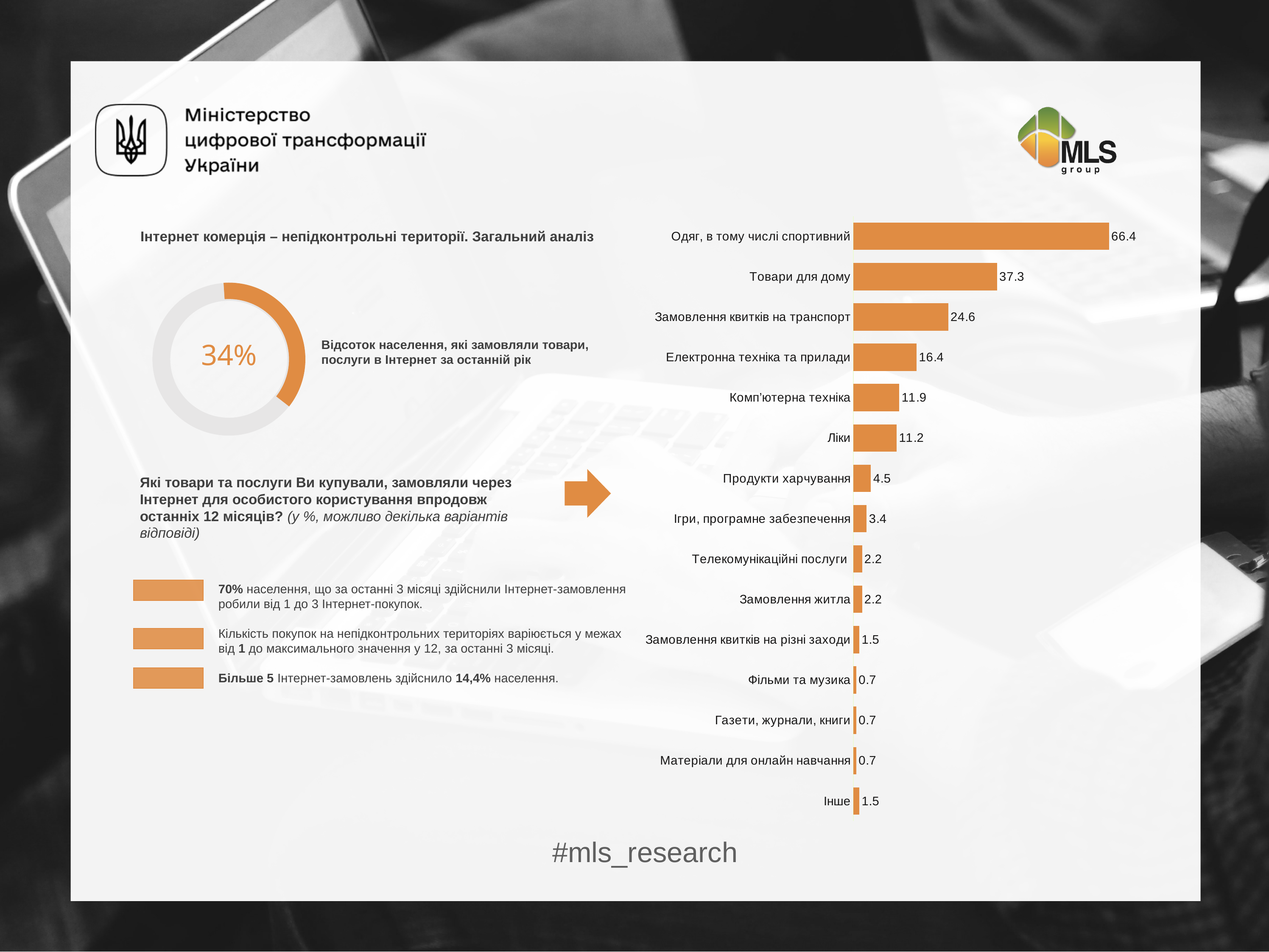
How many categories are shown in the bar chart on the right? 15 What kind of chart is shown on the right side of the slide? Bar chart What percentage is shown in the centre of the donut chart on the left? 34% In the bar chart on the right, what is the value for "Продукти харчування"? 4.5 In the bar chart on the right, what is the value for "Ліки"? 11.2 In the bar chart on the right, which category has the highest value? Одяг, в тому числі спортивний In the bar chart on the right, what is the value for "Одяг, в тому числі спортивний"? 66.4 What colour are the bars in the bar chart on the right? Orange In the bar chart on the right, what is the difference between the values for "Замовлення квитків на транспорт" and "Електронна техніка та прилади"? 8.2 In the bar chart on the right, what is the value for "Товари для дому"? 37.3 In the bar chart on the right, what is the difference between the values for "Одяг, в тому числі спортивний" and "Товари для дому"? 29.1 In the bar chart on the right, which is larger: the value for "Комп’ютерна техніка" or the value for "Продукти харчування"? Комп’ютерна техніка